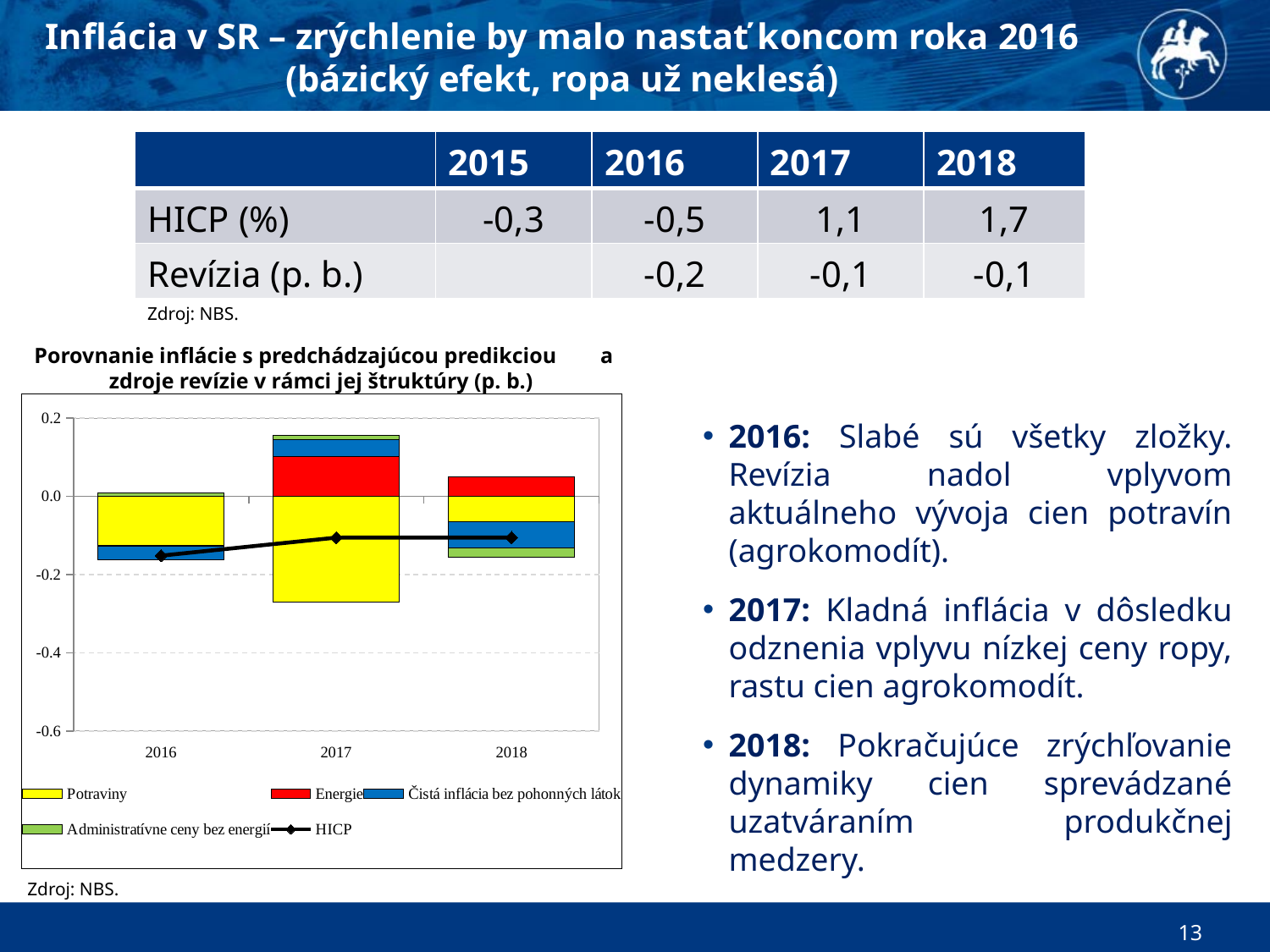
Is the HICP value for 2016 greater or less than -0.2? greater How many years (categories) are shown on the x axis of the chart? 3 Does the HICP line rise or fall from 2016 to 2017? rise Which colour represents Potraviny in the chart? yellow What kind of chart is shown on the slide? combination bar and line chart Which series in the chart is drawn as a line with diamond markers? HICP Is the Potraviny (yellow) contribution for 2017 greater or less than -0.2? less How many series does the chart legend list? 5 Is the HICP value for 2016 greater or less than 0.0? less In which year is the HICP line at its lowest point? 2016